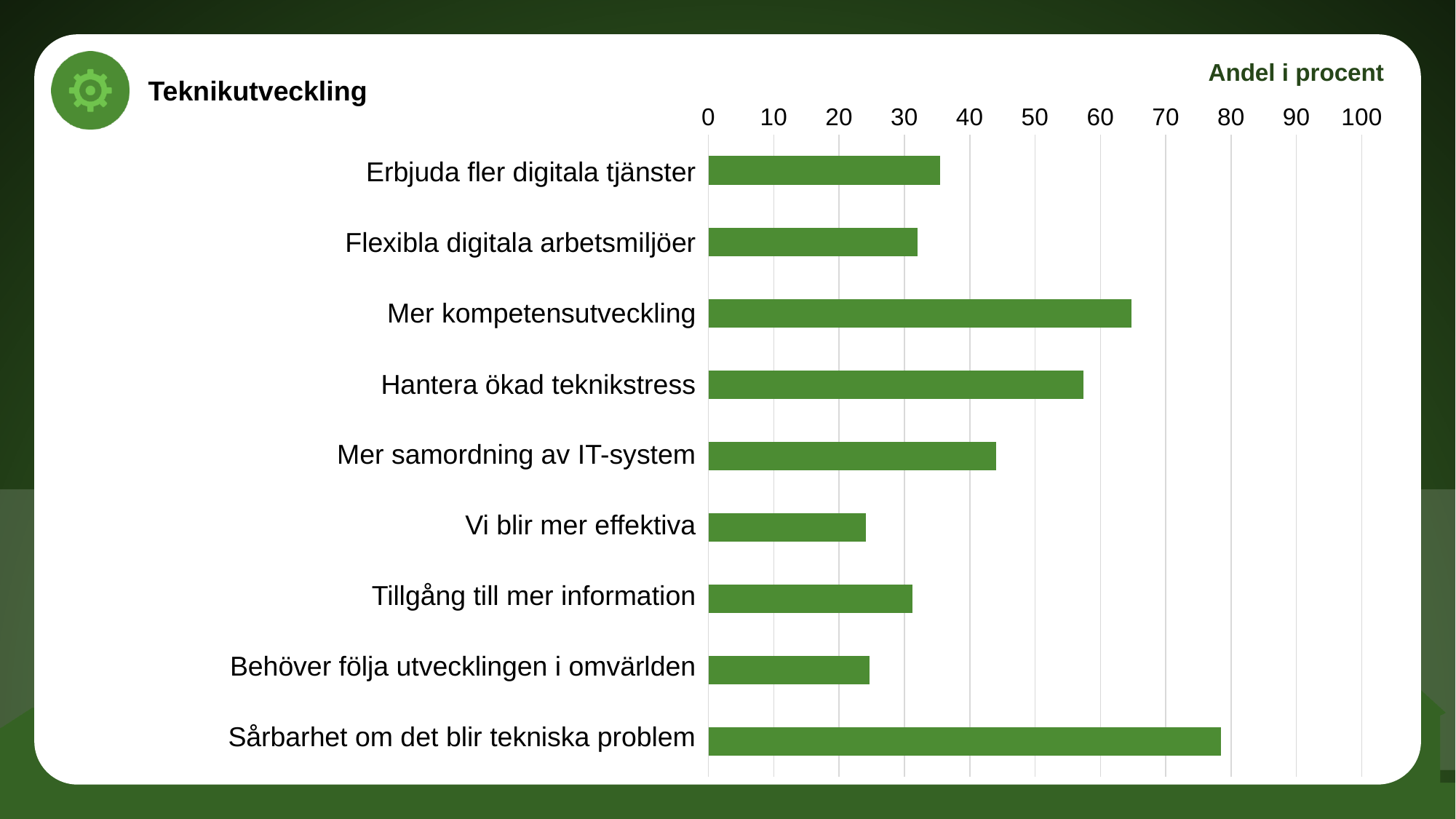
Is the value for Sårbarhet om det blir tekniska problem greater or less than 70? greater What kind of chart is shown on the slide? bar chart Is the value for Mer samordning av IT-system greater or less than 50? less Which is larger, the value for Mer samordning av IT-system or the value for Tillgång till mer information? Mer samordning av IT-system Which category has the highest value? Sårbarhet om det blir tekniska problem Is the value for Mer kompetensutveckling greater or less than 60? greater How many categories are plotted in the chart? 9 Which is larger, the value for Mer kompetensutveckling or the value for Hantera ökad teknikstress? Mer kompetensutveckling What is the title of the chart? Teknikutveckling